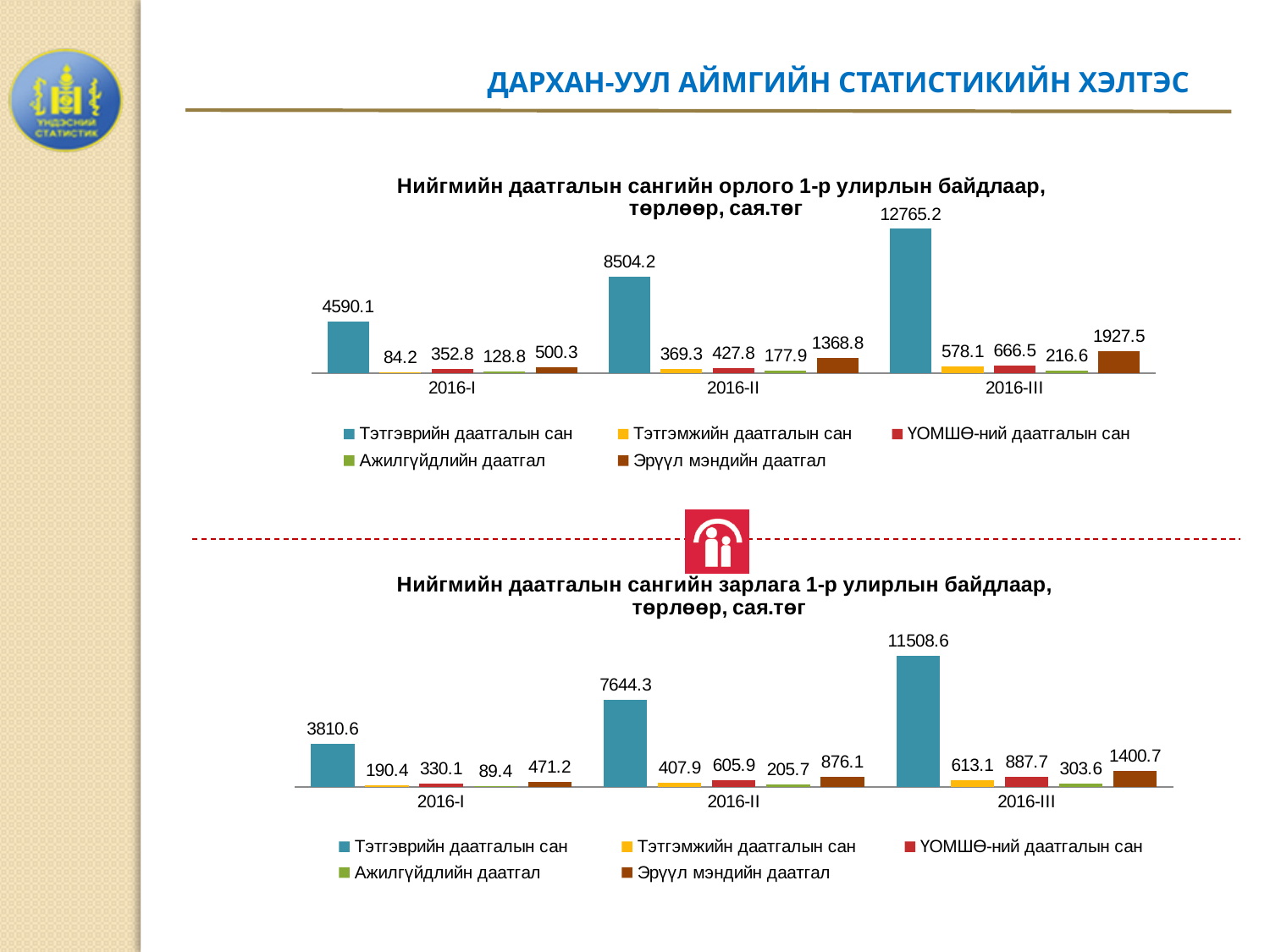
In the top chart (Нийгмийн даатгалын сангийн орлого), what is the difference between the Тэтгэврийн даатгалын сан values for 2016-II and 2016-I? 3914.1 In the top chart (Нийгмийн даатгалын сангийн орлого), what is the value of Эрүүл мэндийн даатгал for 2016-II? 1368.8 What kind of chart is the bottom chart (Нийгмийн даатгалын сангийн зарлага)? Bar chart In the top chart (Нийгмийн даатгалын сангийн орлого), what is the value of Тэтгэврийн даатгалын сан for 2016-III? 12765.2 In the bottom chart (Нийгмийн даатгалын сангийн зарлага), what is the value of Ажилгүйдлийн даатгал for 2016-I? 89.4 In the bottom chart (Нийгмийн даатгалын сангийн зарлага), which is larger for 2016-II: Тэтгэмжийн даатгалын сан or ҮОМШӨ-ний даатгалын сан? ҮОМШӨ-ний даатгалын сан In the bottom chart (Нийгмийн даатгалын сангийн зарлага), which period has the highest value for Тэтгэврийн даатгалын сан? 2016-III How many series does the legend of the top chart (Нийгмийн даатгалын сангийн орлого) list? 5 How many periods are shown on the x axis of the bottom chart (Нийгмийн даатгалын сангийн зарлага)? 3 In the top chart (Нийгмийн даатгалын сангийн орлого), does the value of Эрүүл мэндийн даатгал rise or fall from 2016-I to 2016-III? Rise In the bottom chart (Нийгмийн даатгалын сангийн зарлага), what is the value of ҮОМШӨ-ний даатгалын сан for 2016-III? 887.7 In the top chart (Нийгмийн даатгалын сангийн орлого), which series has the lowest value for 2016-I? Тэтгэмжийн даатгалын сан